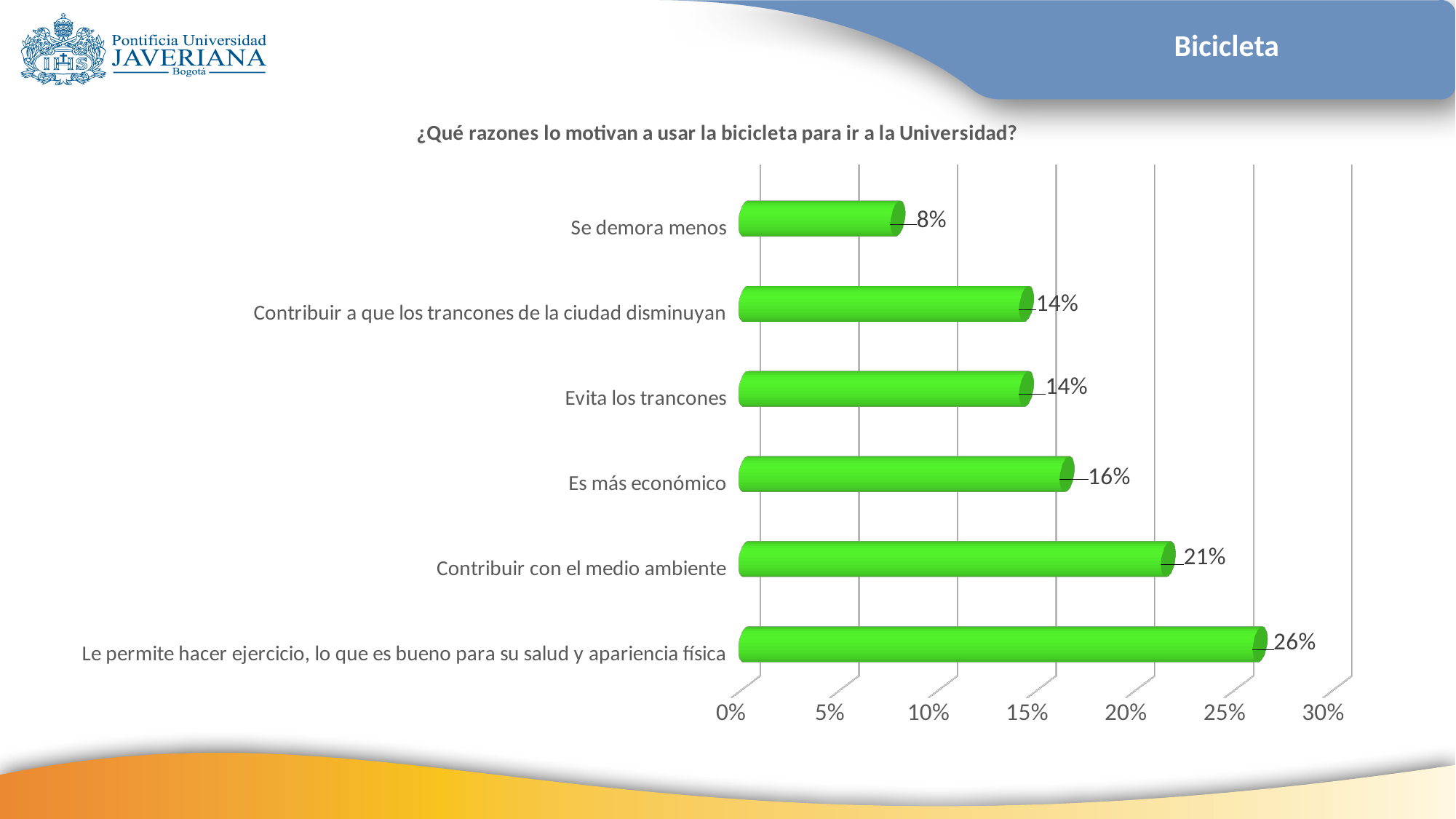
What is the title of the chart? ¿Qué razones lo motivan a usar la bicicleta para ir a la Universidad? What is the difference between the values for "Le permite hacer ejercicio, lo que es bueno para su salud y apariencia física" and "Contribuir con el medio ambiente"? 5% What value is shown for "Evita los trancones"? 14% What value is shown for "Es más económico"? 16% How many categories are shown in the chart? 6 Which category has the highest value? Le permite hacer ejercicio, lo que es bueno para su salud y apariencia física Which is larger, the value for "Es más económico" or the value for "Evita los trancones"? Es más económico What value is shown for "Se demora menos"? 8% Which category has the lowest value? Se demora menos What kind of chart is shown on the slide? Bar chart What is the difference between the values for "Es más económico" and "Se demora menos"? 8% What value is shown for "Contribuir con el medio ambiente"? 21%